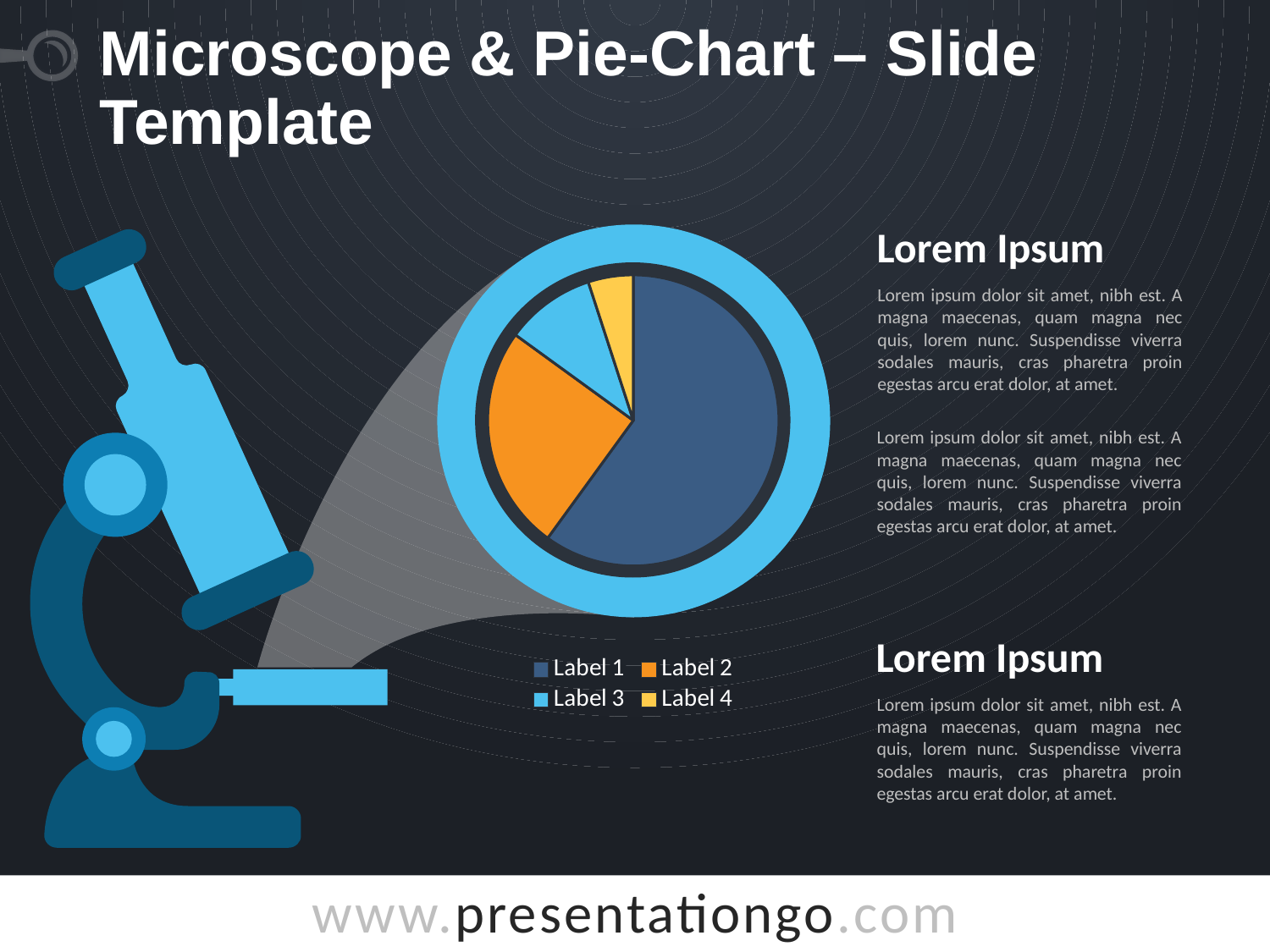
Which slice is larger in the pie chart, Label 2 or Label 3? Label 2 How many slices does the pie chart have? 4 What kind of chart is shown on the slide? pie chart Which legend entry is shown in yellow? Label 4 How many entries does the legend of the pie chart list? 4 Which slice is larger in the pie chart, Label 3 or Label 4? Label 3 Which category has the largest slice in the pie chart? Label 1 Which category has the second-largest slice in the pie chart? Label 2 Which category has the smallest slice in the pie chart? Label 4 Which slice is larger in the pie chart, Label 1 or Label 2? Label 1 What colour is the Label 2 slice in the pie chart? orange